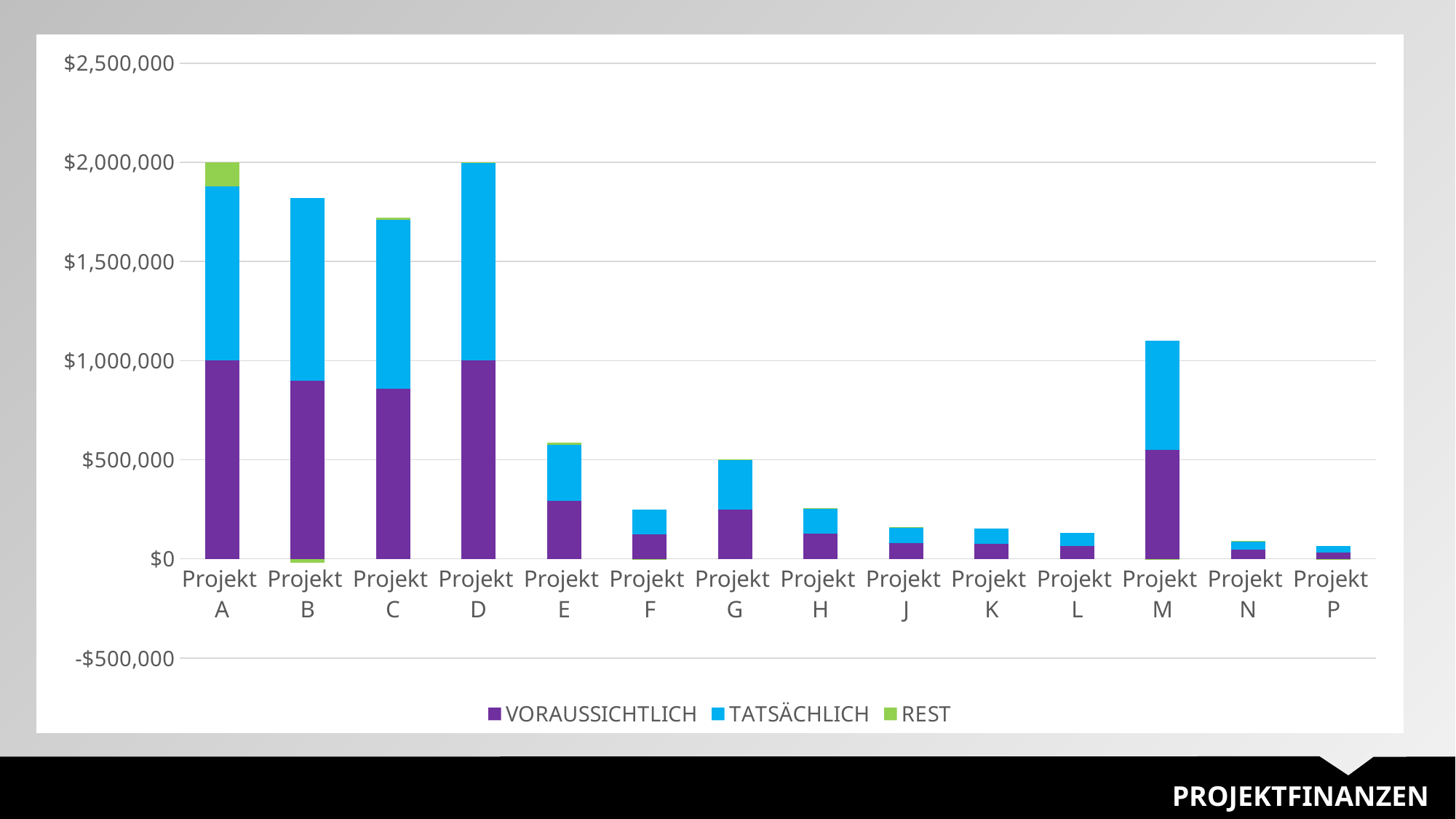
Is the VORAUSSICHTLICH value for Projekt C greater or less than $1,000,000? less Which series is shown in green in the legend? REST How many series does the legend list? 3 Which has the larger total bar, Projekt M or Projekt G? Projekt M Is the total bar for Projekt F greater or less than $500,000? less Is the total bar for Projekt M greater or less than $1,000,000? greater Which has the larger total bar, Projekt B or Projekt C? Projekt B What title is shown in the bottom-right corner of the slide? PROJEKTFINANZEN What kind of chart is shown on the slide? Stacked bar chart Which project has the lowest total bar? Projekt P How many projects (categories) are plotted on the x axis? 14